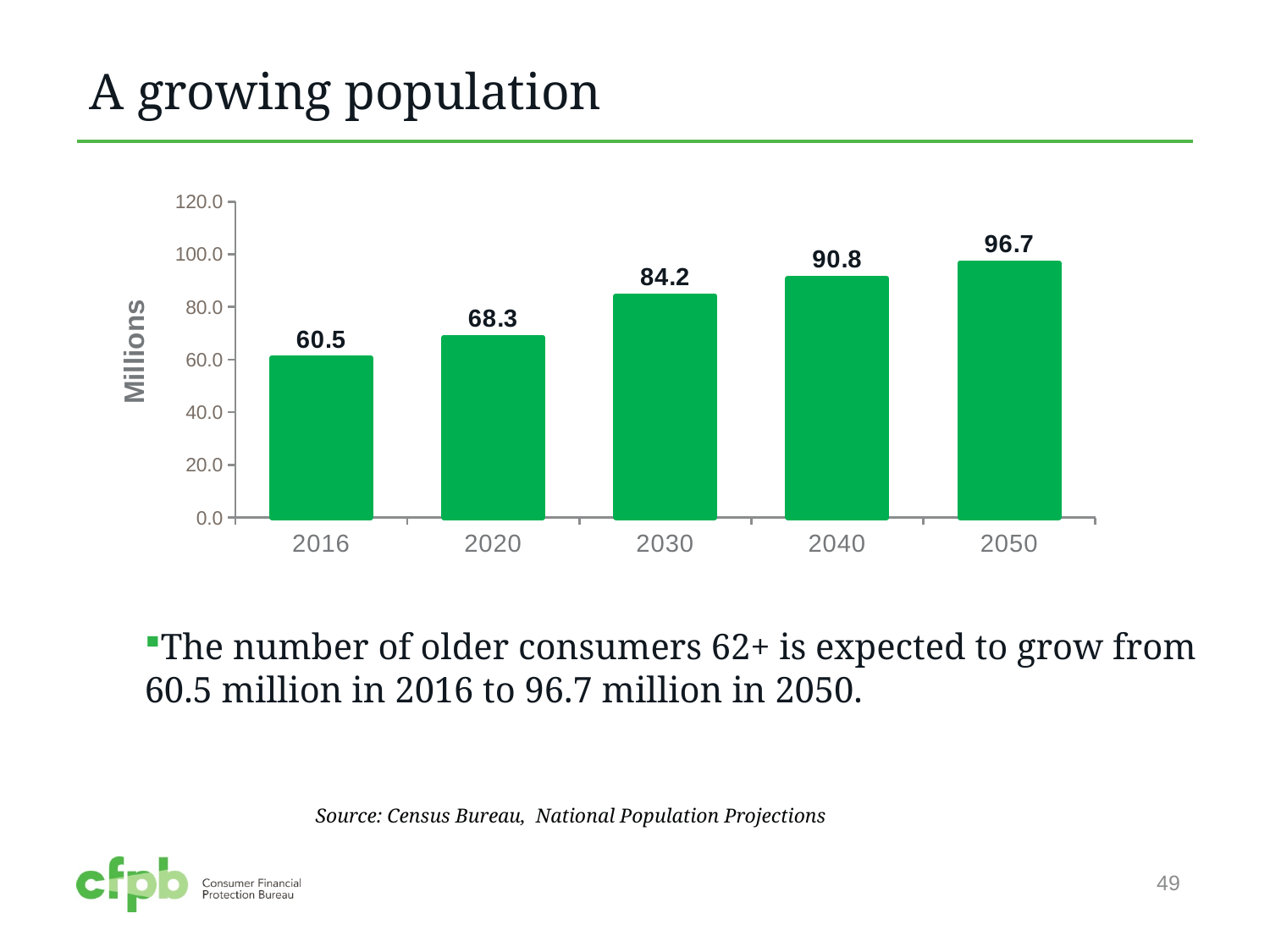
What is the value for 2050? 96.7 Which year has the highest value? 2050 What is the difference between the values for 2040 and 2030? 6.6 Is the value for 2030 greater or less than 80.0? greater What is the difference between the values for 2050 and 2016? 36.2 What is the value for 2016? 60.5 What kind of chart is shown on the slide? bar chart Which is larger, the value for 2020 or the value for 2040? 2040 How many years are shown on the x axis? 5 What is the value for 2030? 84.2 Do the values rise or fall from 2016 to 2050? rise Which year has the lowest value? 2016